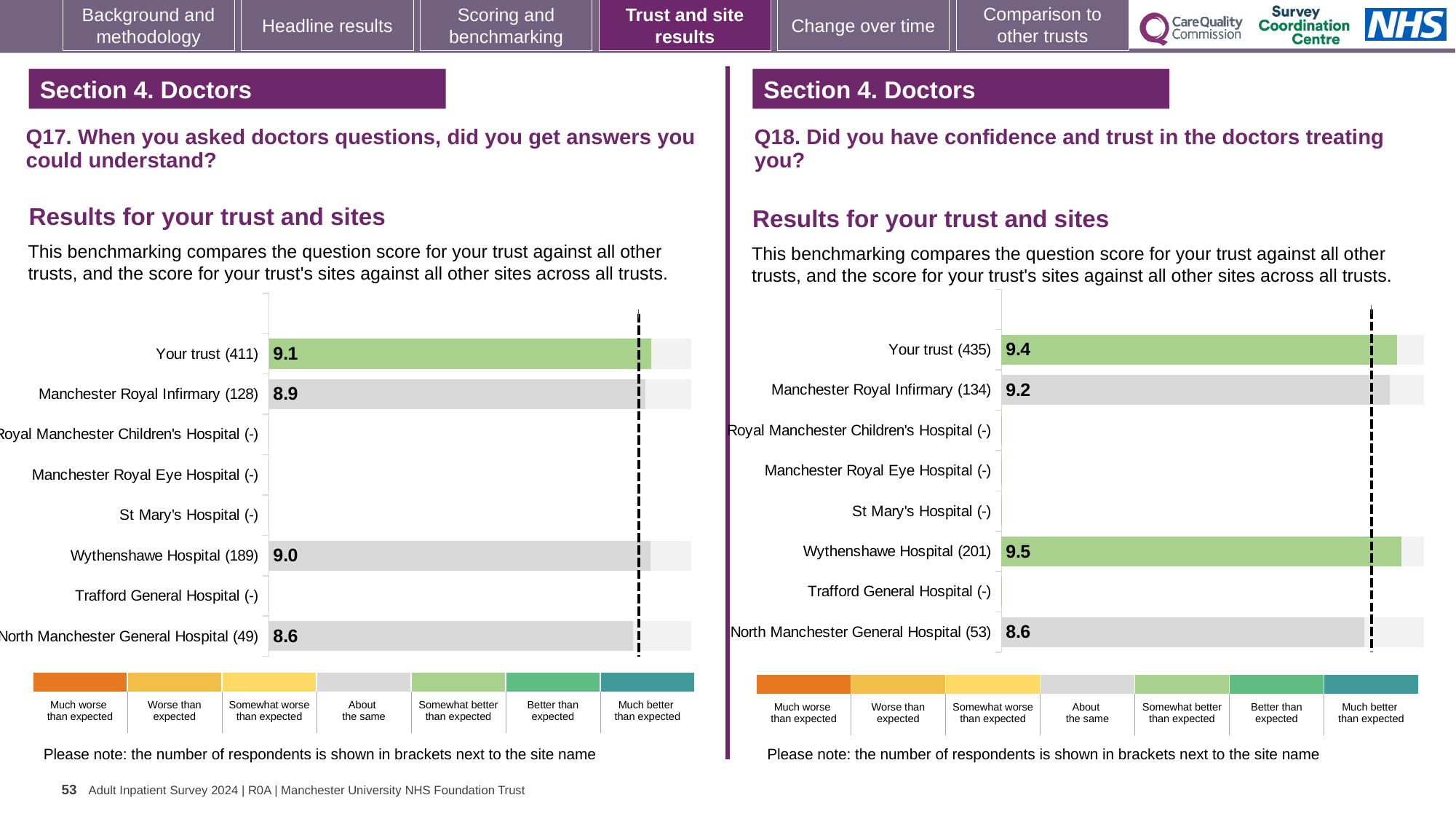
In the Q18 chart (right), what is the score for Wythenshawe Hospital? 9.5 In the Q18 chart (right), what is the difference between the scores for Your trust and North Manchester General Hospital? 0.8 In the Q17 chart (left), which is higher: the score for Wythenshawe Hospital or for Manchester Royal Infirmary? Wythenshawe Hospital In the Q18 chart (right), how many respondents are shown in brackets for Your trust? 435 How many site rows (categories) are listed in the Q18 chart (right)? 8 In the Q17 chart (left), what is the score for North Manchester General Hospital? 8.6 In the Q17 chart (left), which site with a plotted score has the lowest value? North Manchester General Hospital In the Q18 chart (right), what is the score for Manchester Royal Infirmary? 9.2 In the Q17 chart (left), what is the difference between the scores for Your trust and Manchester Royal Infirmary? 0.2 In the Q18 chart (right), which site with a plotted score has the highest value? Wythenshawe Hospital In the Q17 chart (left), what is the score for Your trust? 9.1 What kind of chart is used in the Q17 chart (left)? Bar chart